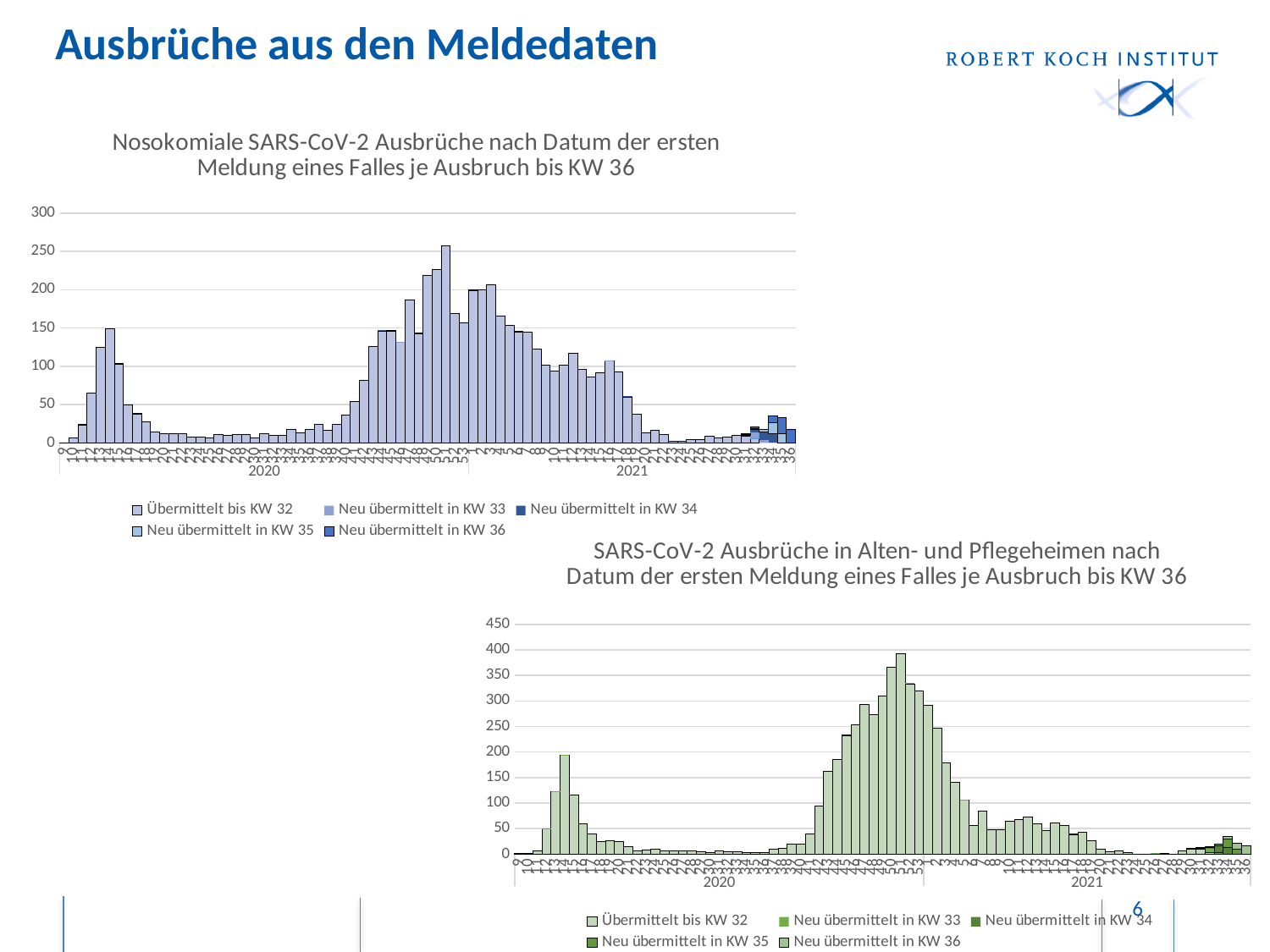
What kind of chart is the bottom chart titled 'SARS-CoV-2 Ausbrüche in Alten- und Pflegeheimen nach Datum der ersten Meldung eines Falles je Ausbruch bis KW 36'? Bar chart What kind of chart is the top chart titled 'Nosokomiale SARS-CoV-2 Ausbrüche nach Datum der ersten Meldung eines Falles je Ausbruch bis KW 36'? Bar chart In the top chart (Nosokomiale SARS-CoV-2 Ausbrüche), is the highest bar greater or less than 200? greater What is the first legend entry of the bottom chart (Ausbrüche in Alten- und Pflegeheimen)? Übermittelt bis KW 32 How many series does the legend of the bottom chart (Ausbrüche in Alten- und Pflegeheimen) list? 5 How many series does the legend of the top chart (Nosokomiale SARS-CoV-2 Ausbrüche) list? 5 In the bottom chart (Ausbrüche in Alten- und Pflegeheimen), is the highest bar greater or less than 350? greater In the bottom chart (Ausbrüche in Alten- und Pflegeheimen), which year contains the highest bar, 2020 or 2021? 2020 What is the highest value shown on the y axis of the bottom chart (Ausbrüche in Alten- und Pflegeheimen)? 450 In the bottom chart (Ausbrüche in Alten- und Pflegeheimen), is the peak of the first wave in spring 2020 greater or less than 150? greater In the top chart (Nosokomiale SARS-CoV-2 Ausbrüche), do the bars rise or fall from the start of 2021 to the middle of 2021? fall